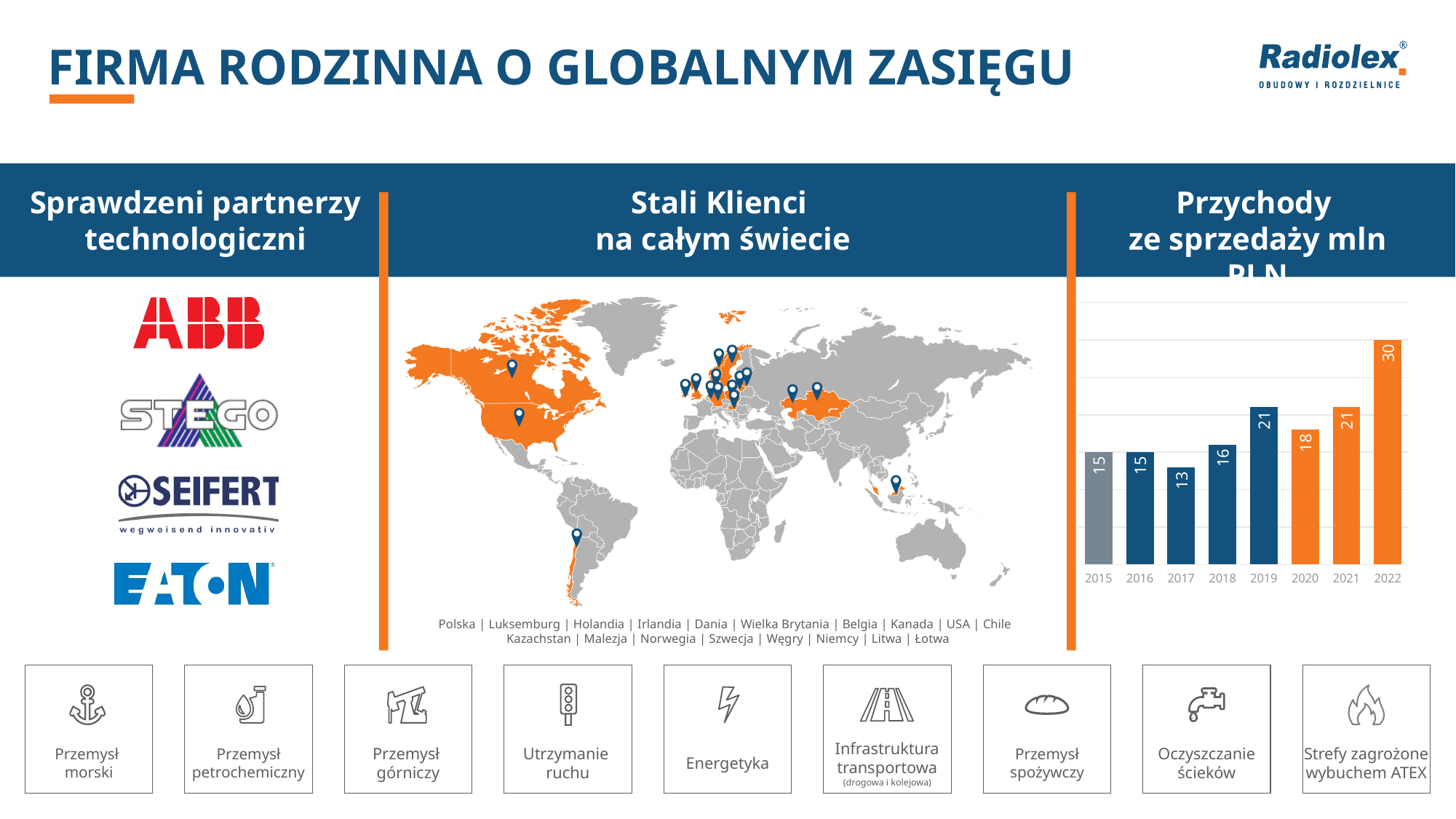
What is the difference between the 2019 and 2018 values in the sales revenue chart? 5 How many years are shown in the sales revenue chart? 8 Which is larger in the sales revenue chart, the value for 2019 or the value for 2020? 2019 Which year has the highest value in the sales revenue chart? 2022 What kind of chart is used to show sales revenue? Bar chart What was the value for 2020 in the sales revenue chart? 18 What is the title of the chart on the right side of the slide? Przychody ze sprzedaży mln PLN What was the value for 2022 in the sales revenue chart? 30 What is the difference between the 2022 and 2021 values in the sales revenue chart? 9 Which year has the lowest value in the sales revenue chart? 2017 What was the value for 2017 in the sales revenue chart? 13 Do the values in the sales revenue chart generally rise or fall from 2015 to 2022? Rise